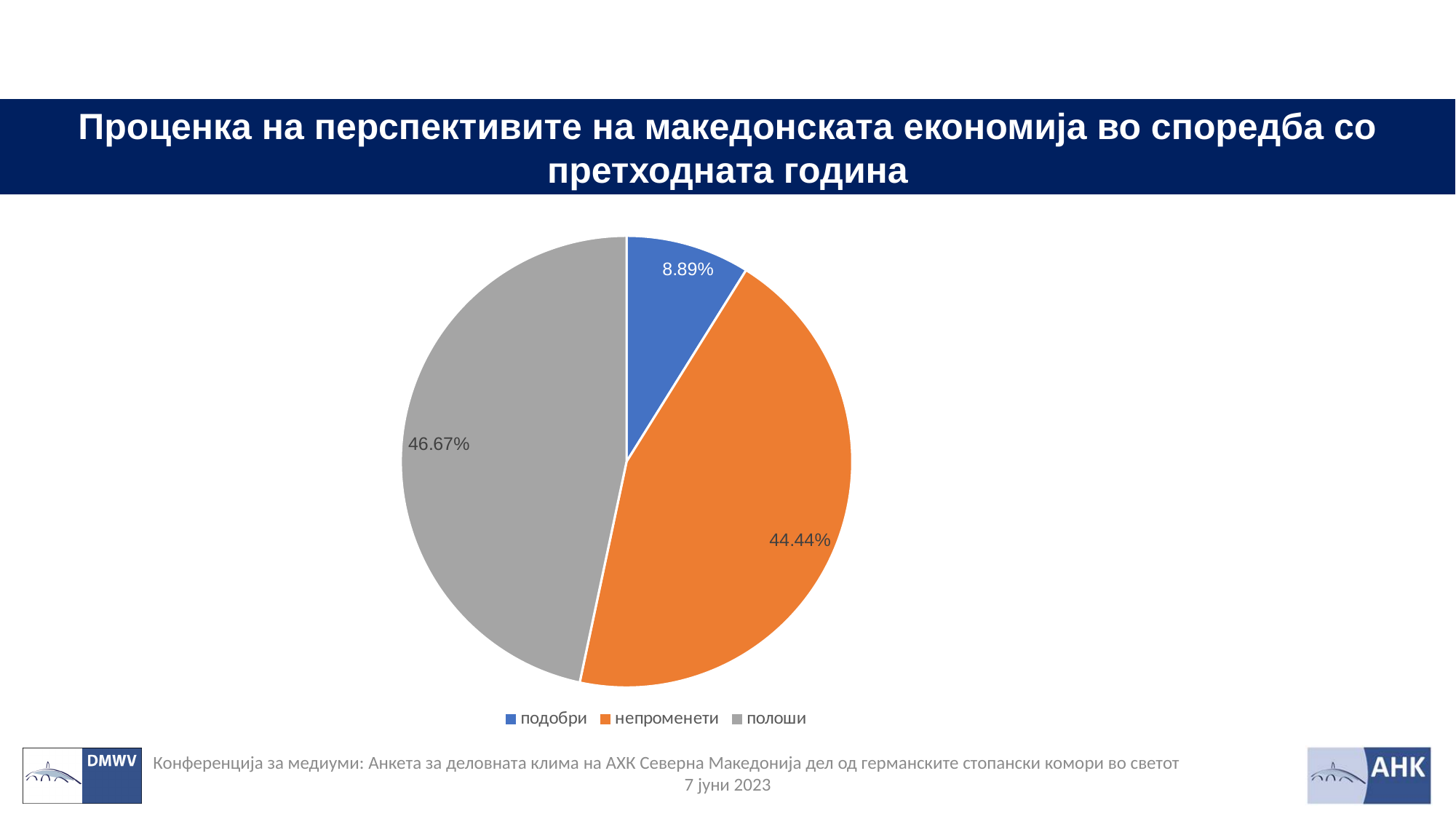
Which category has the largest slice of the pie? полоши What is the difference in percentage points between "полоши" and "непроменети"? 2.23% Which is larger, the slice for "непроменети" or the slice for "полоши"? полоши How many slices does the pie chart have? 3 What is the value shown for "непроменети"? 44.44% How many entries does the legend list? 3 Which category has the smallest slice of the pie? подобри What is the difference in percentage points between "непроменети" and "подобри"? 35.55% What colour is the slice for "непроменети"? orange What share of the pie does the slice "подобри" represent? 8.89% What kind of chart is shown on the slide? pie chart What is the value shown for "полоши"? 46.67%